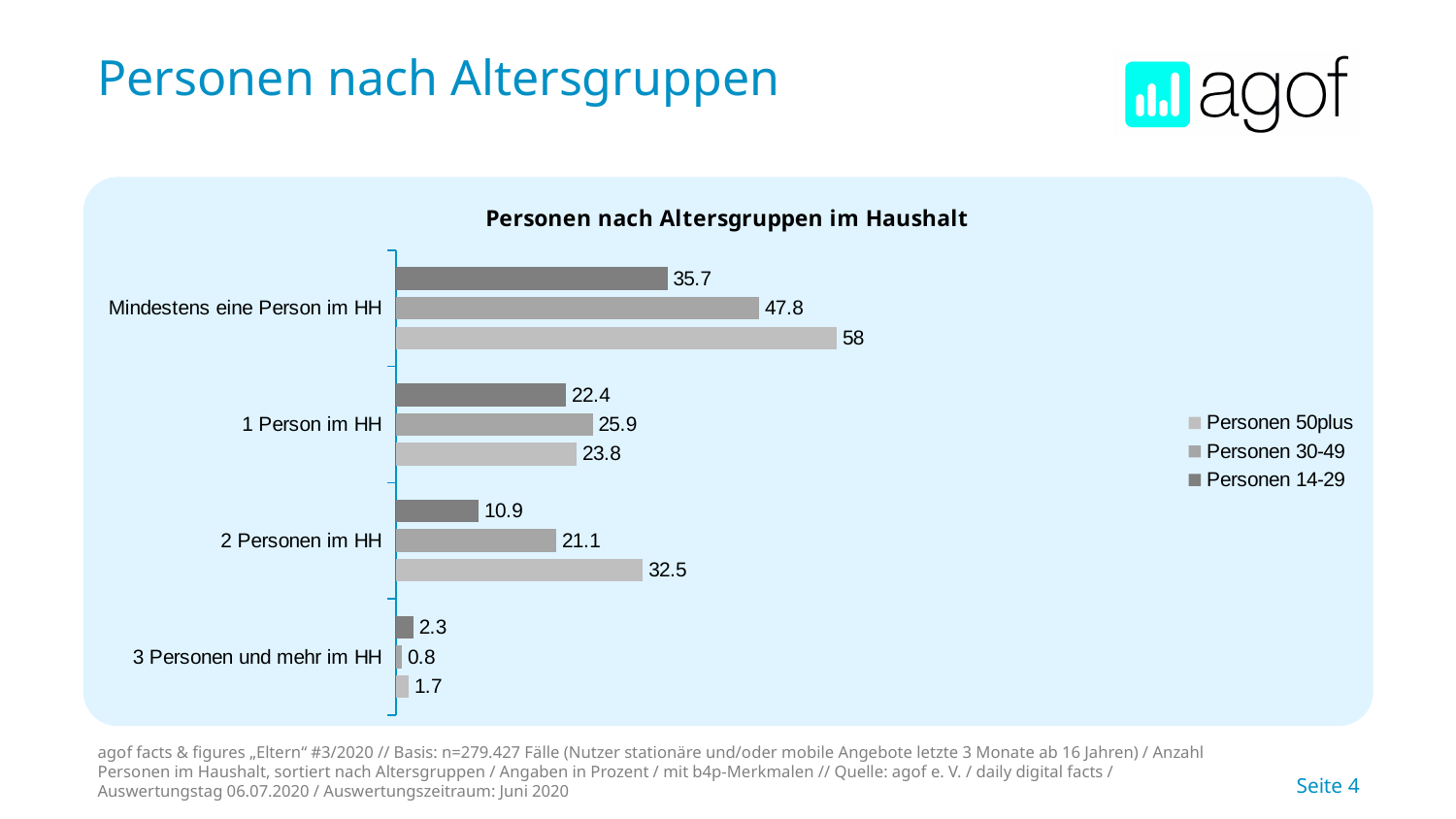
What is the value for Personen 30-49 in the category '1 Person im HH'? 25.9 What is the title of the chart? Personen nach Altersgruppen im Haushalt How many series does the legend list? 3 What is the difference between the Personen 50plus and Personen 14-29 values in the category '2 Personen im HH'? 21.6 Which series has the highest value in the category 'Mindestens eine Person im HH'? Personen 50plus Which household category has the lowest value for Personen 50plus? 3 Personen und mehr im HH What is the value for Personen 50plus in the category 'Mindestens eine Person im HH'? 58 What type of chart is shown on the slide? bar chart In the category '1 Person im HH', which is larger: the value for Personen 30-49 or for Personen 50plus? Personen 30-49 What is the value for Personen 14-29 in the category '2 Personen im HH'? 10.9 How many household categories are shown on the chart? 4 What is the value for Personen 30-49 in the category '3 Personen und mehr im HH'? 0.8